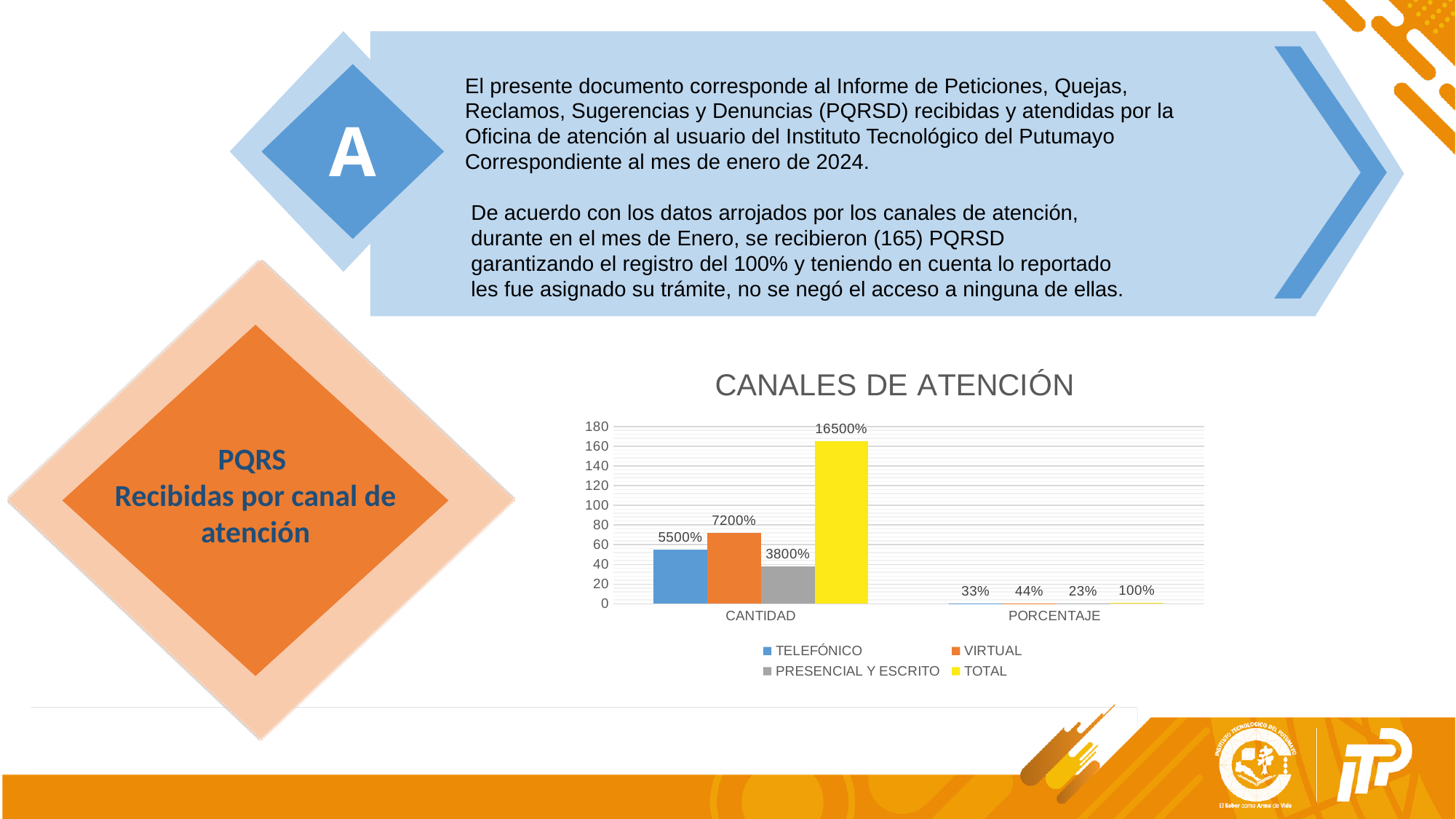
What is the data label for PRESENCIAL Y ESCRITO in the CANTIDAD category? 3800% In the CANTIDAD category, which is larger: TELEFÓNICO or VIRTUAL? VIRTUAL What is the data label for PRESENCIAL Y ESCRITO in the PORCENTAJE category? 23% What is the data label for TOTAL in the CANTIDAD category? 16500% What is the data label for TELEFÓNICO in the CANTIDAD category? 5500% What is the title of the chart on the slide? CANALES DE ATENCIÓN How many categories are shown on the x axis of the chart? 2 What is the data label for VIRTUAL in the PORCENTAJE category? 44% What kind of chart is shown on the slide? bar chart How many series does the chart legend list? 4 Which series has the lowest value in the CANTIDAD category? PRESENCIAL Y ESCRITO What is the data label for VIRTUAL in the CANTIDAD category? 7200%